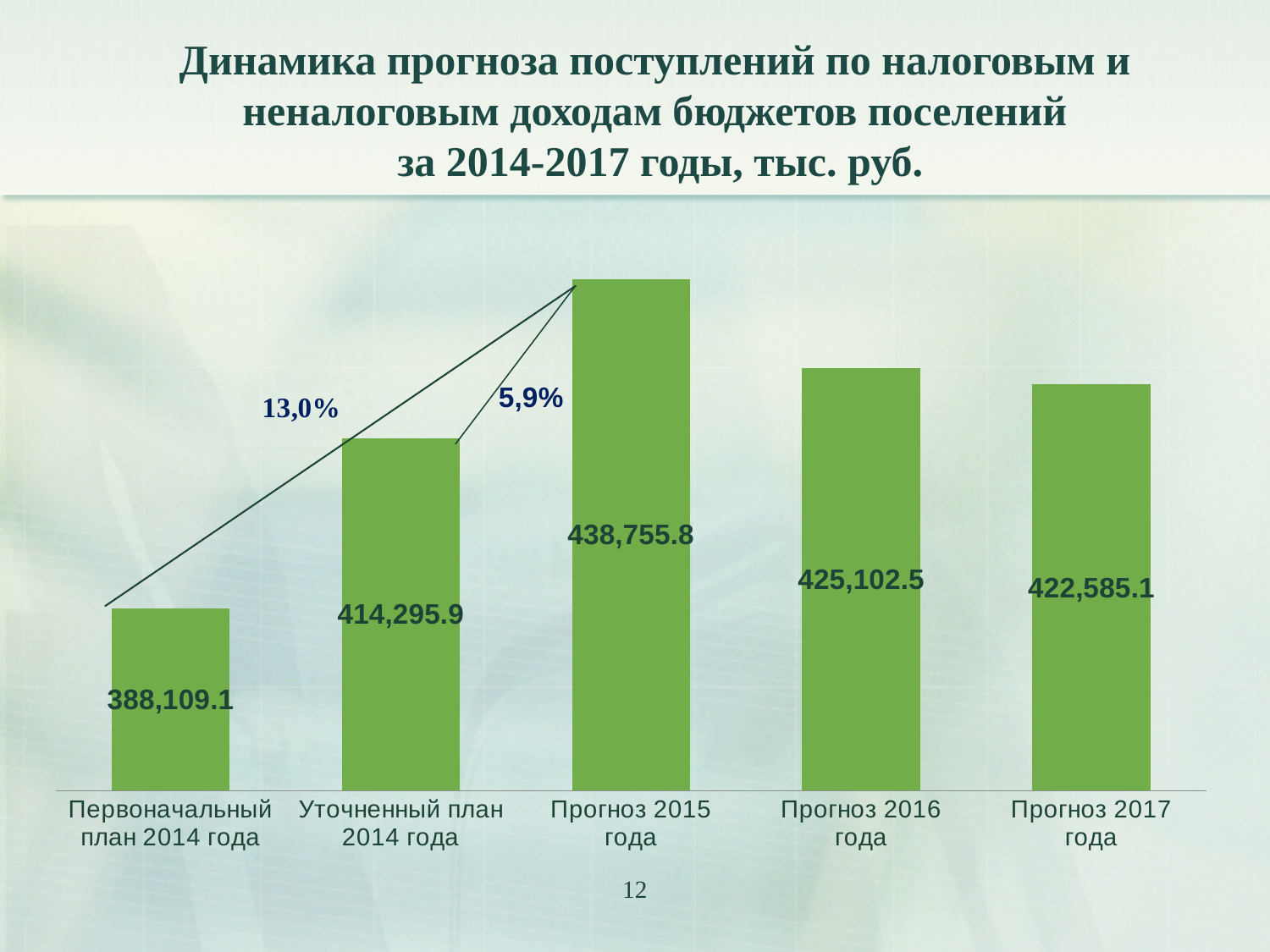
What is the value for Прогноз 2017 года? 422,585.1 What is the value for Первоначальный план 2014 года? 388,109.1 How many bars are shown in the chart? 5 What is the value for Прогноз 2015 года? 438,755.8 Which category has the lowest value? Первоначальный план 2014 года Which category has the highest value? Прогноз 2015 года What percentage change is annotated between Уточненный план 2014 года and Прогноз 2015 года? 5,9% Do the values rise or fall from Прогноз 2015 года to Прогноз 2017 года? Fall What is the difference between Уточненный план 2014 года and Первоначальный план 2014 года? 26,186.8 What kind of chart is shown on the slide? Bar chart What is the difference between Прогноз 2015 года and Уточненный план 2014 года? 24,459.9 Which is larger, Прогноз 2016 года or Прогноз 2017 года? Прогноз 2016 года